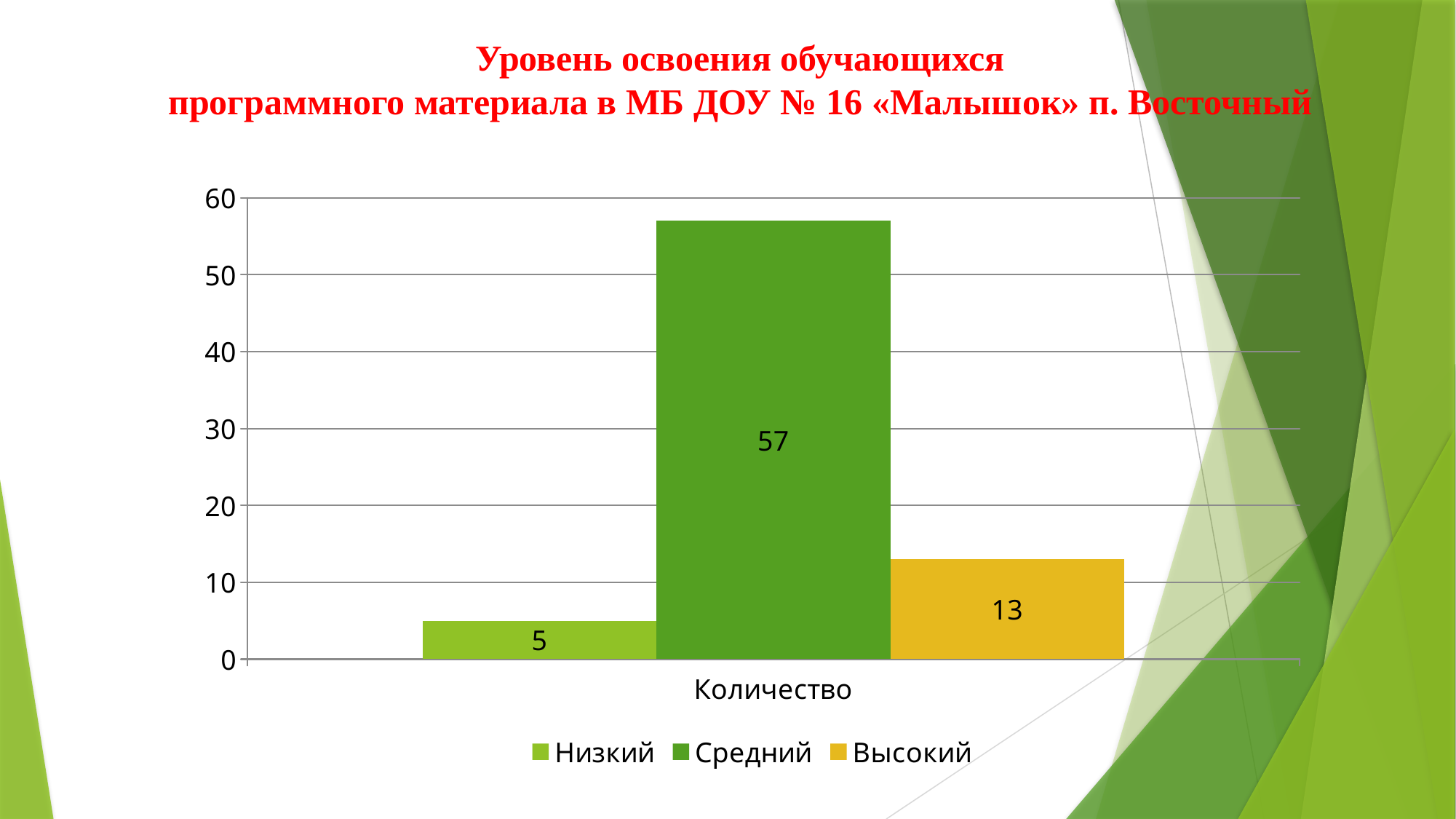
How many series does the legend list? 3 What is the value for Средний? 57 What is the value for Высокий? 13 What is the difference between the values for Высокий and Низкий? 8 Which is larger, the value for Высокий or the value for Низкий? Высокий Which series has the lowest value? Низкий What is the value for Низкий? 5 Which series has the highest value? Средний What is the difference between the values for Средний and Высокий? 44 What kind of chart is shown on the slide? bar chart What is the category label on the x axis? Количество Is the value for Средний greater or less than 50? greater